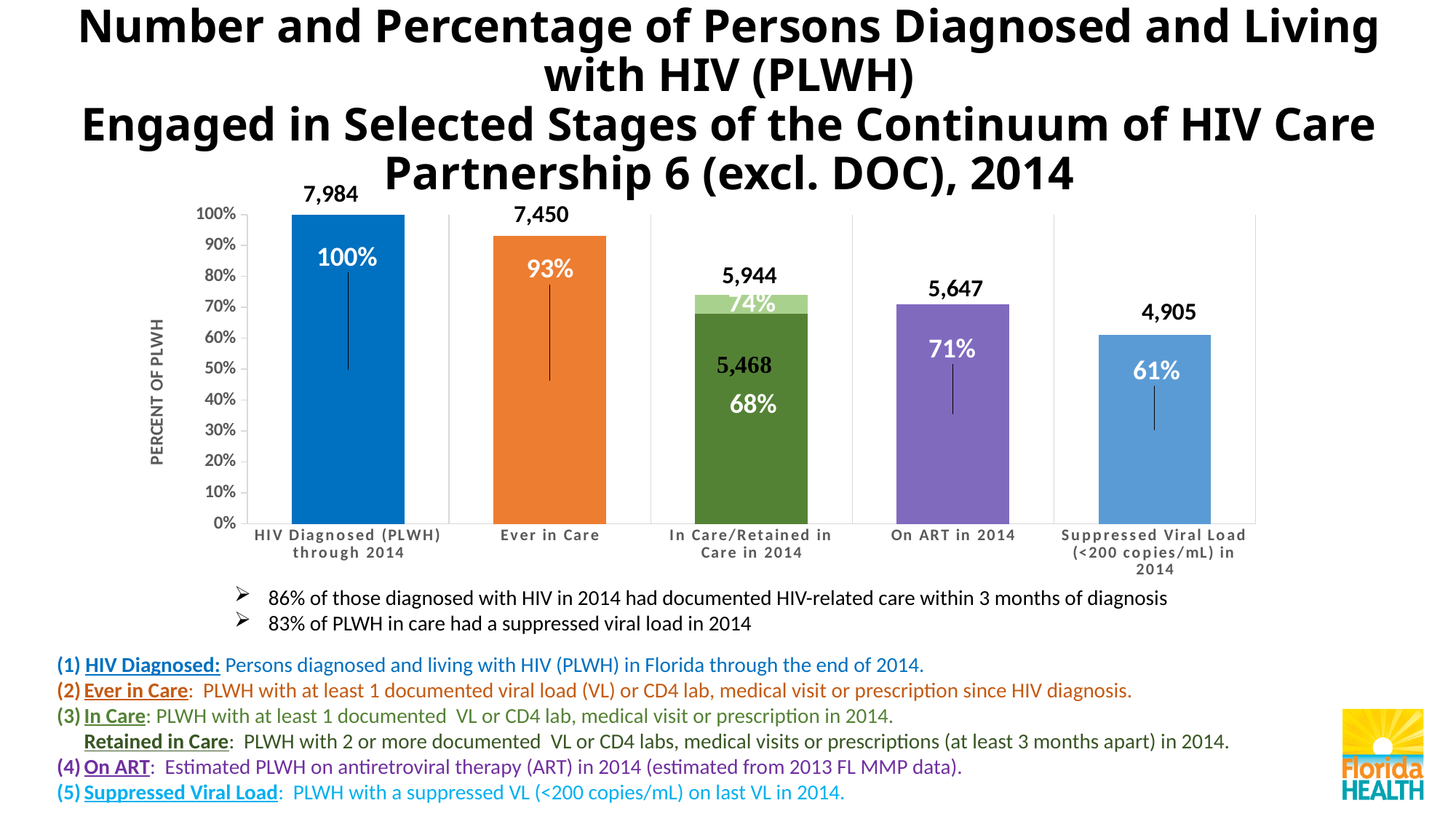
Which category has the highest number of persons? HIV Diagnosed (PLWH) through 2014 What number is shown for the 'In Care' portion (top of the bar) in the 'In Care/Retained in Care in 2014' category? 5,944 What percentage is shown for the 'Retained in Care' portion (darker green) of the 'In Care/Retained in Care in 2014' bar? 68% How many categories are shown on the x axis of the chart? 5 What is the number of persons for the 'HIV Diagnosed (PLWH) through 2014' bar? 7,984 Which category has the lowest number of persons? Suppressed Viral Load (<200 copies/mL) in 2014 What kind of chart is shown on the slide? Bar chart What percentage is shown for 'Suppressed Viral Load (<200 copies/mL) in 2014'? 61% What percentage is shown for the 'Ever in Care' bar? 93% Do the percentages rise or fall moving from left to right across the chart? Fall What is the number of persons shown for 'On ART in 2014'? 5,647 What is the difference in number of persons between 'HIV Diagnosed (PLWH) through 2014' and 'Ever in Care'? 534